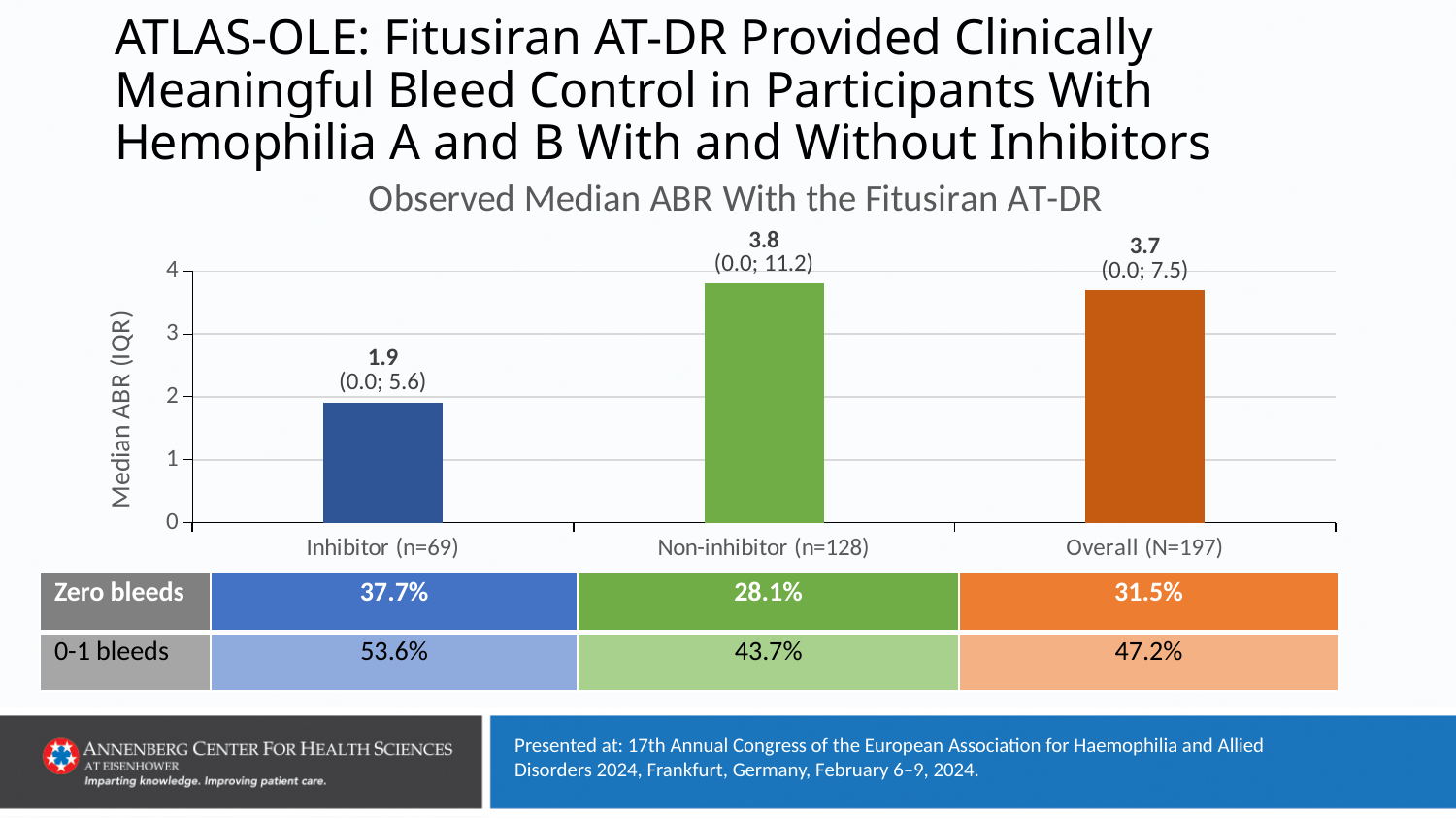
What is the title of the chart? Observed Median ABR With the Fitusiran AT-DR Which group has the highest median ABR? Non-inhibitor (n=128) What type of chart is shown on the slide? Bar chart How many groups are plotted in the chart? 3 What is the difference in median ABR between the Non-inhibitor (n=128) and Inhibitor (n=69) groups? 1.9 What is the IQR shown for the Non-inhibitor (n=128) group? (0.0; 11.2) Which group has the lowest median ABR? Inhibitor (n=69) What is the median ABR for the Overall (N=197) group? 3.7 Is the median ABR for the Inhibitor (n=69) group greater or less than 2? less What is the median ABR for the Inhibitor (n=69) group? 1.9 Which has a larger median ABR, the Inhibitor (n=69) group or the Overall (N=197) group? Overall (N=197) What is the median ABR for the Non-inhibitor (n=128) group? 3.8